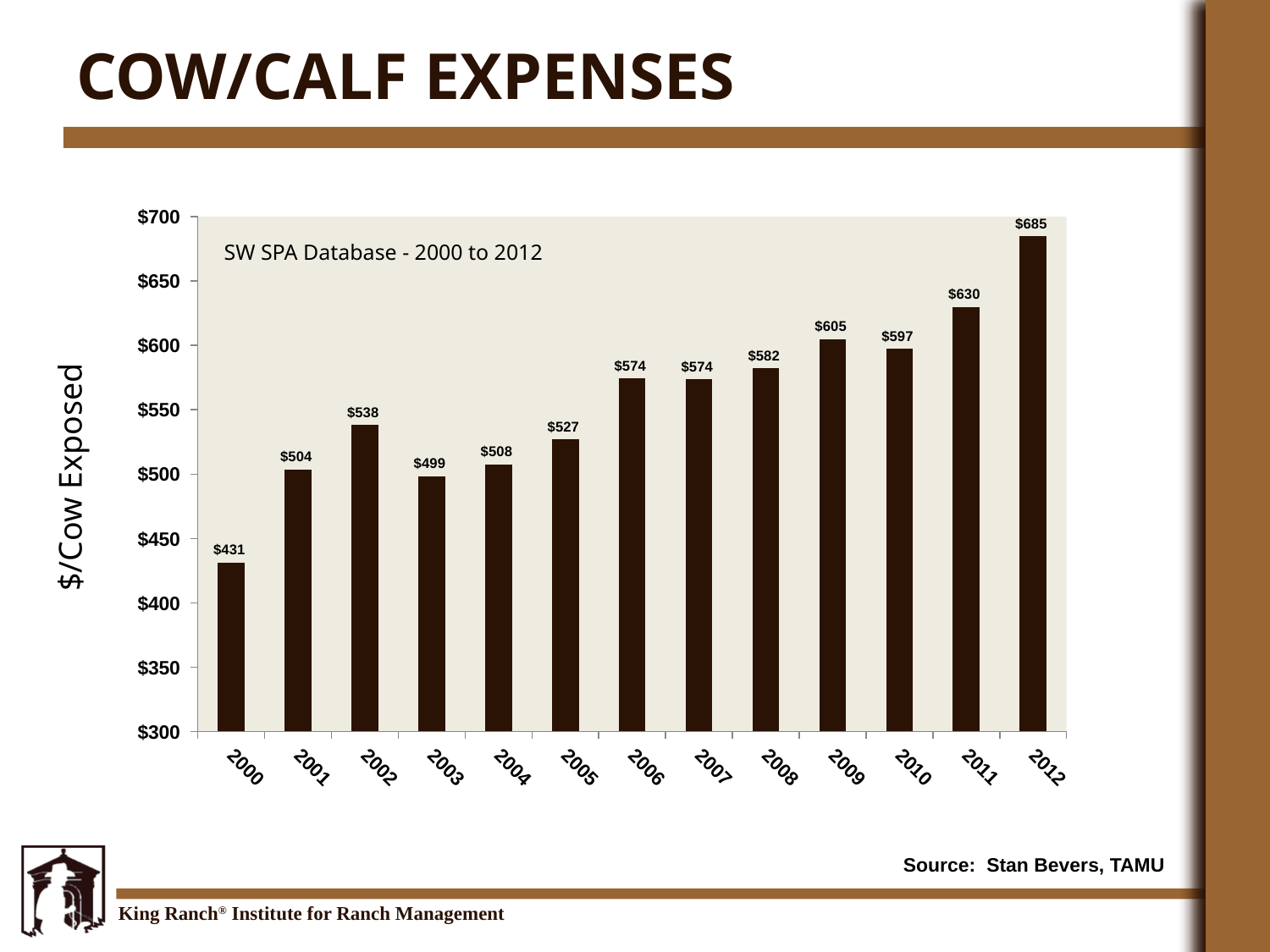
What is the label on the y axis? $/Cow Exposed Which is larger, the value for 2003 or the value for 2004? 2004 Which year has the highest expense per cow exposed? 2012 How many years are shown on the x axis? 13 Which year has the lowest expense per cow exposed? 2000 What is the value shown for 2012? $685 What is the cow/calf expense per cow exposed in 2000? $431 What kind of chart is shown on the slide? bar chart What is the difference between the 2012 value and the 2000 value? $254 What is the difference between the 2011 value and the 2010 value? $33 Is the value for 2008 greater or less than $600? less What is the value shown for 2009? $605